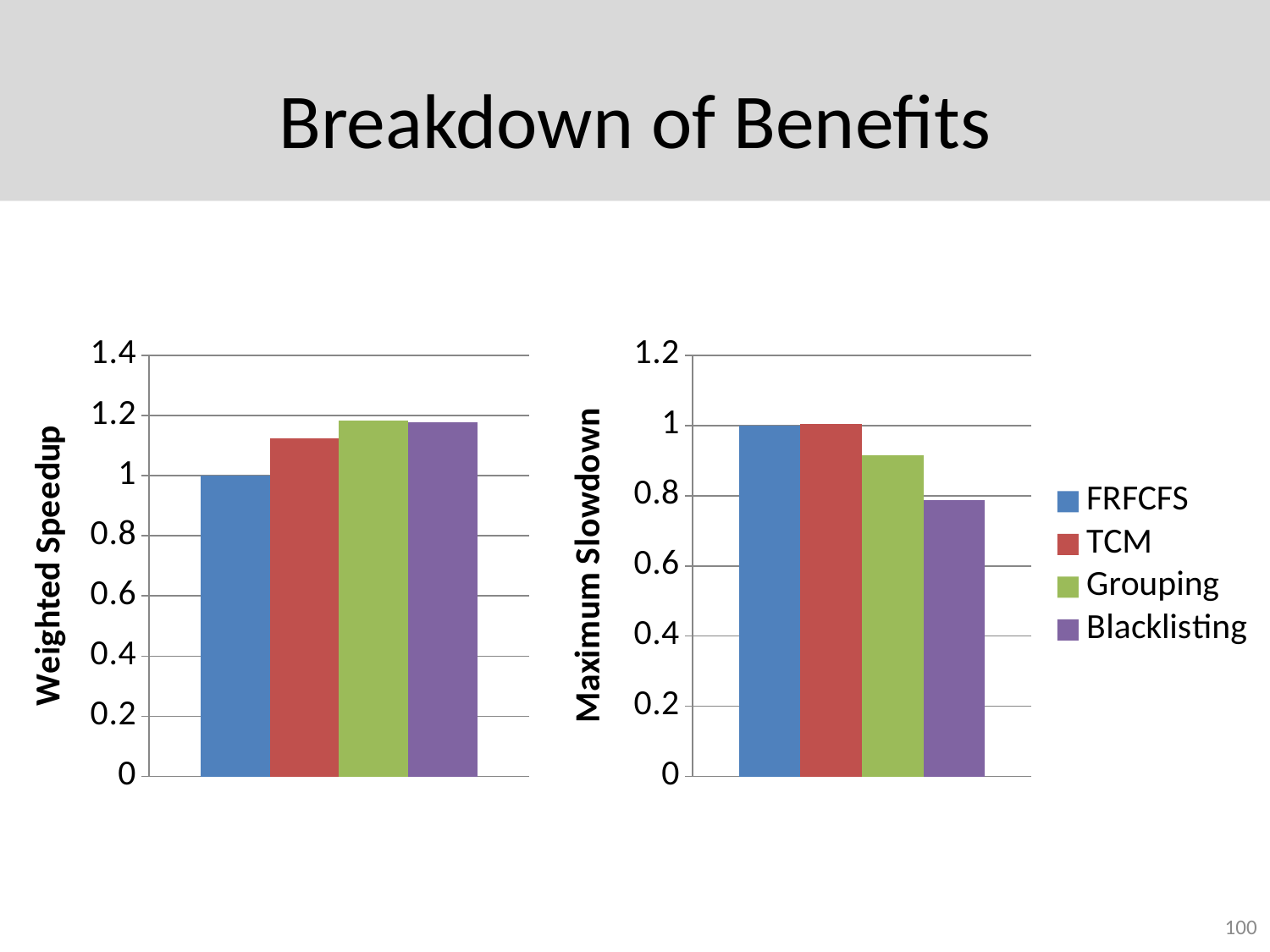
In the Maximum Slowdown chart, which is larger, Grouping or Blacklisting? Grouping In the Maximum Slowdown chart, is the value for Blacklisting greater or less than 1? less In the Weighted Speedup chart, is the value for TCM greater or less than 1? greater What kind of chart is the Weighted Speedup chart on the left? bar chart In the Maximum Slowdown chart, which series has the lowest value? Blacklisting In the Weighted Speedup chart, which is larger, TCM or FRFCFS? TCM In the Weighted Speedup chart, which series has the lowest value? FRFCFS In the Weighted Speedup chart, what is the value for FRFCFS? 1 How many series does the legend list? 4 What is the y-axis label of the chart on the right? Maximum Slowdown How many bars are plotted in the Maximum Slowdown chart? 4 In the Maximum Slowdown chart, is the value for Grouping greater or less than 1? less